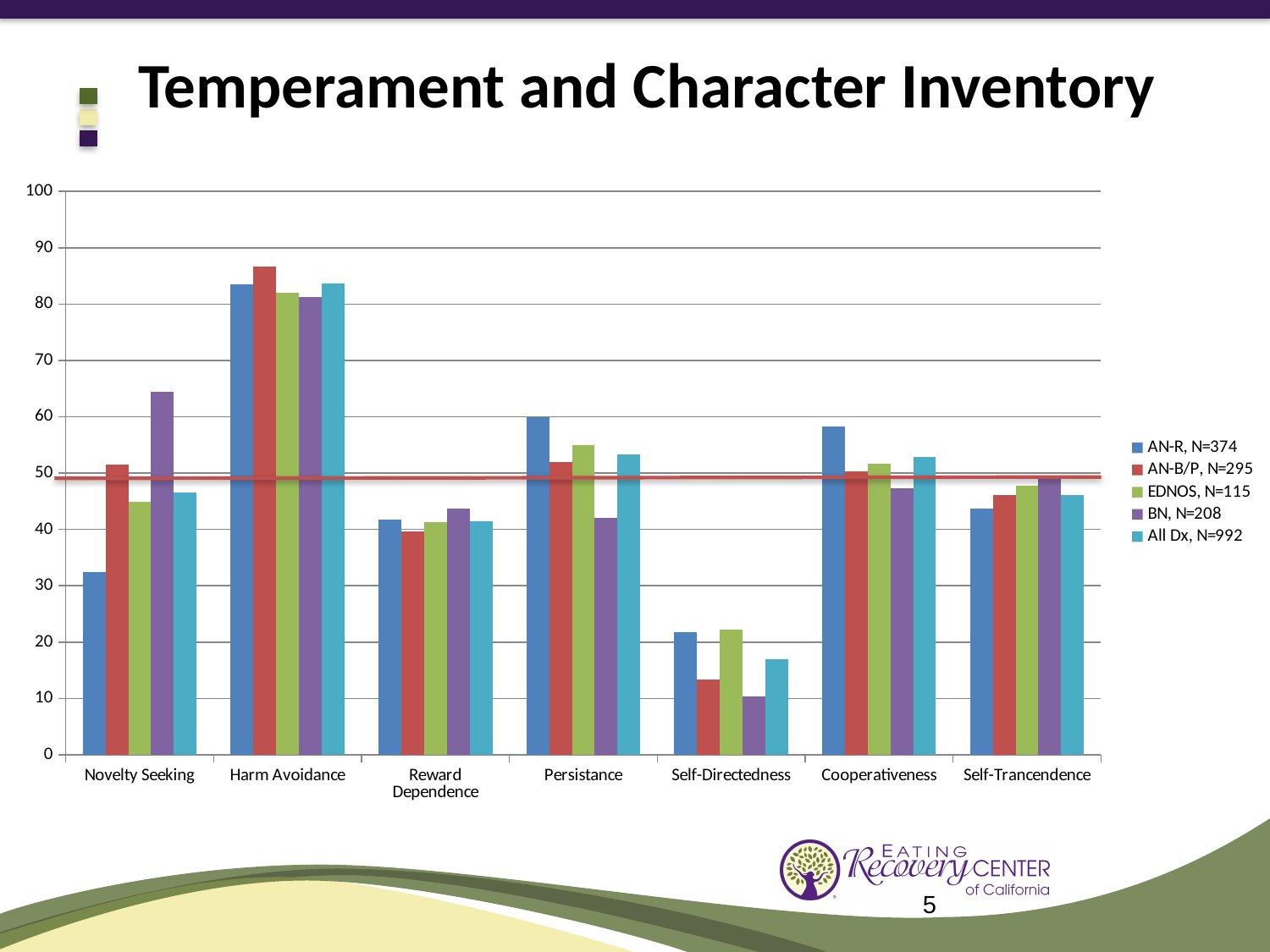
What kind of chart is shown on the slide? bar chart Within the Novelty Seeking category, which series has the highest value? BN, N=208 In Persistance, which is larger: the value for AN-R, N=374 or the value for BN, N=208? AN-R, N=374 For the AN-R, N=374 series, which category has the highest value? Harm Avoidance Which legend entry has N=992? All Dx, N=992 In Novelty Seeking, which is larger: the value for BN, N=208 or the value for AN-R, N=374? BN, N=208 Is the value for AN-B/P, N=295 in Harm Avoidance greater or less than 80? greater How many series does the legend list? 5 Is the value for BN, N=208 in Self-Directedness greater or less than 20? less How many categories are shown along the x axis of the chart? 7 Is the value for AN-R, N=374 in Novelty Seeking greater or less than 40? less For the BN, N=208 series, which category has the lowest value? Self-Directedness